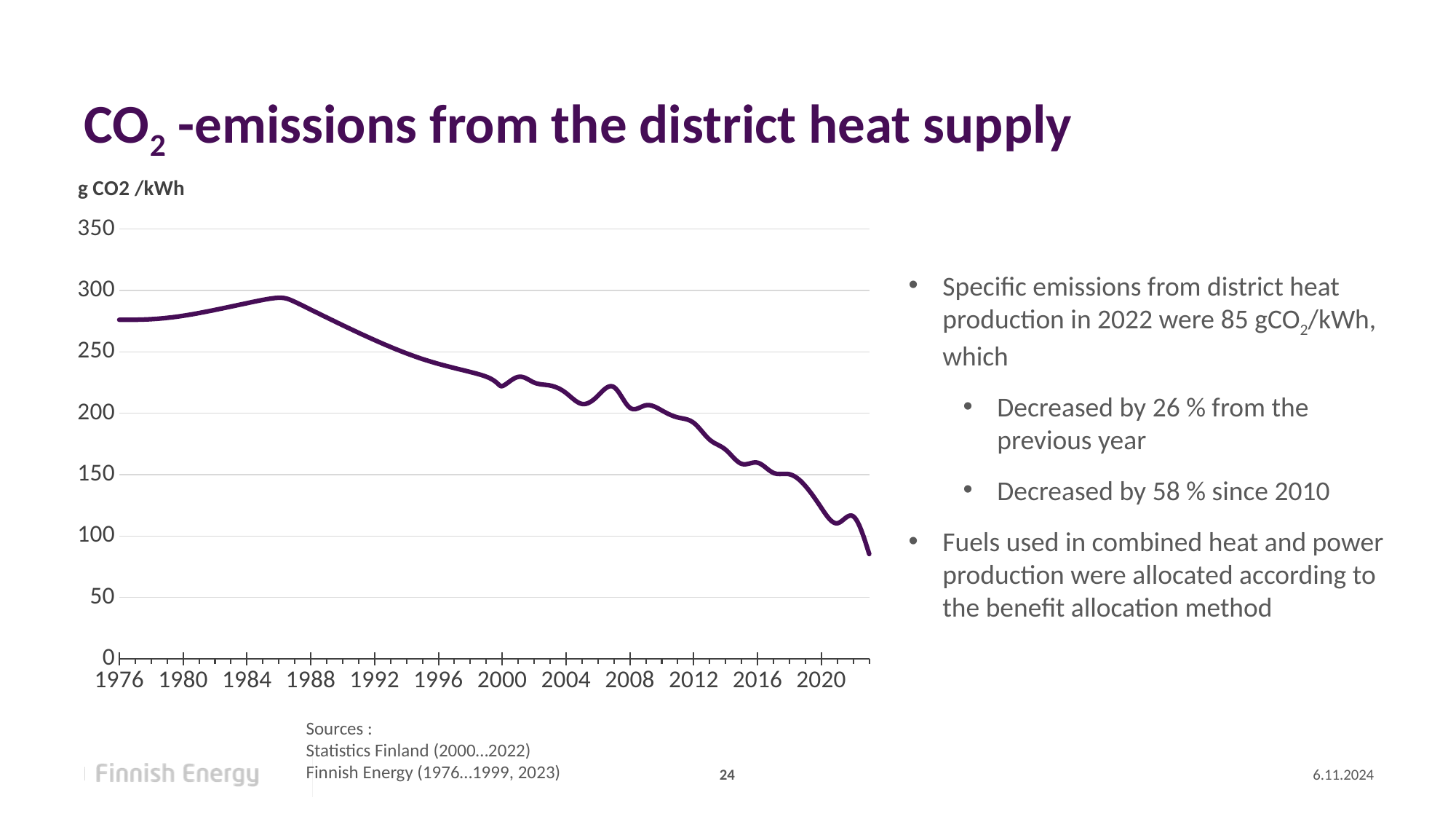
Is the value for 2020 greater or less than 100? greater What unit is shown on the vertical axis of the chart? g CO2 /kWh Is the value for 2012 greater or less than 200? less Is the highest value on the line greater or less than 300? less Do the CO2 emission values generally rise or fall from 1988 to the end of the series? fall What kind of chart is shown on the slide? line chart What is the title of the chart on the slide? CO2 -emissions from the district heat supply Which is larger, the value for 1988 or the value for 2004? 1988